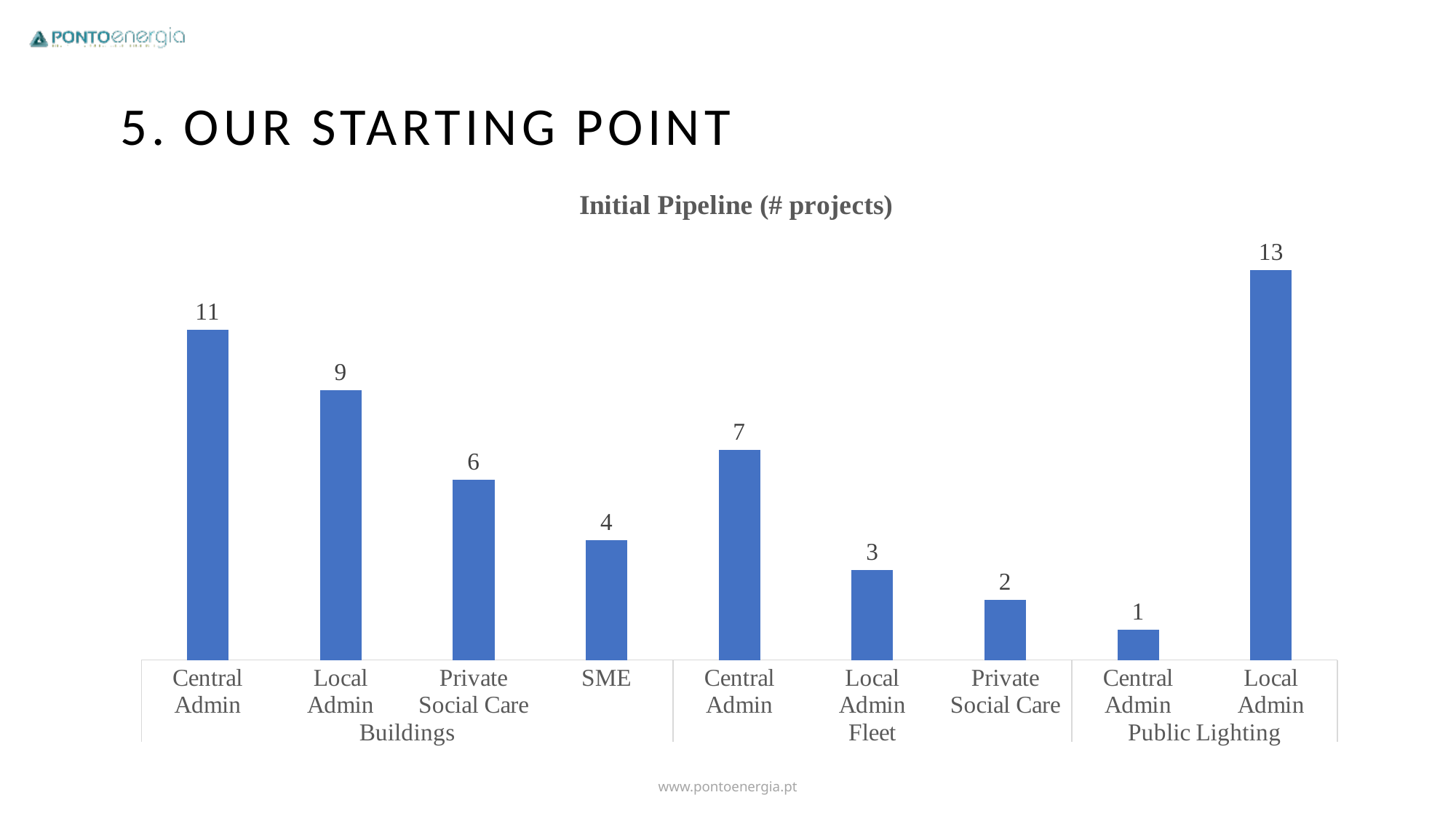
How many bars are shown in the chart? 9 What is the value for SME under Buildings? 4 Which is larger: Local Admin under Buildings or Local Admin under Fleet? Local Admin under Buildings What is the value for Central Admin under Buildings? 11 What is the value for Private Social Care under Fleet? 2 What is the value for Local Admin under Public Lighting? 13 Which category has the lowest number of projects? Central Admin (Public Lighting) What type of chart is shown? Bar chart What is the total number of projects across the three Fleet categories? 12 What is the title of the chart? Initial Pipeline (# projects) What is the difference between Central Admin under Buildings and Central Admin under Fleet? 4 Which category has the highest number of projects? Local Admin (Public Lighting)